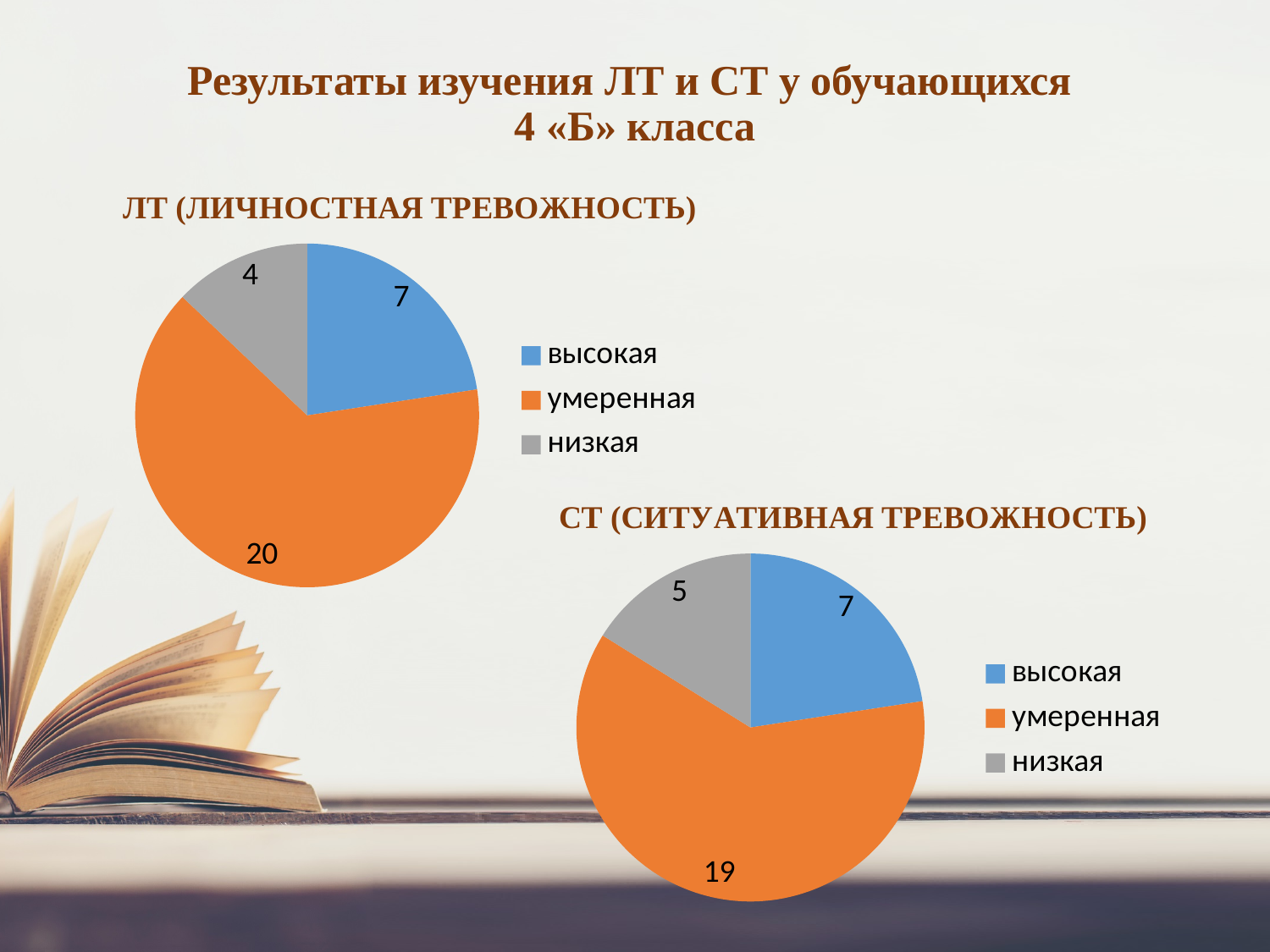
In the СТ (СИТУАТИВНАЯ ТРЕВОЖНОСТЬ) chart, what is the value for умеренная? 19 In the ЛТ (ЛИЧНОСТНАЯ ТРЕВОЖНОСТЬ) chart, what is the value for низкая? 4 In the СТ (СИТУАТИВНАЯ ТРЕВОЖНОСТЬ) chart, what is the difference between the values for высокая and низкая? 2 In the ЛТ (ЛИЧНОСТНАЯ ТРЕВОЖНОСТЬ) chart, which is larger, высокая or низкая? высокая How many categories does the СТ (СИТУАТИВНАЯ ТРЕВОЖНОСТЬ) chart show? 3 What type of chart is the ЛТ (ЛИЧНОСТНАЯ ТРЕВОЖНОСТЬ) chart? pie chart In the СТ (СИТУАТИВНАЯ ТРЕВОЖНОСТЬ) chart, which category has the smallest slice? низкая In the ЛТ (ЛИЧНОСТНАЯ ТРЕВОЖНОСТЬ) chart, what is the difference between the values for умеренная and высокая? 13 In the ЛТ (ЛИЧНОСТНАЯ ТРЕВОЖНОСТЬ) chart, what is the value for умеренная? 20 In the СТ (СИТУАТИВНАЯ ТРЕВОЖНОСТЬ) chart, what is the value for высокая? 7 In the ЛТ (ЛИЧНОСТНАЯ ТРЕВОЖНОСТЬ) chart, which category has the largest slice? умеренная In the СТ (СИТУАТИВНАЯ ТРЕВОЖНОСТЬ) chart, what colour is the умеренная slice? orange